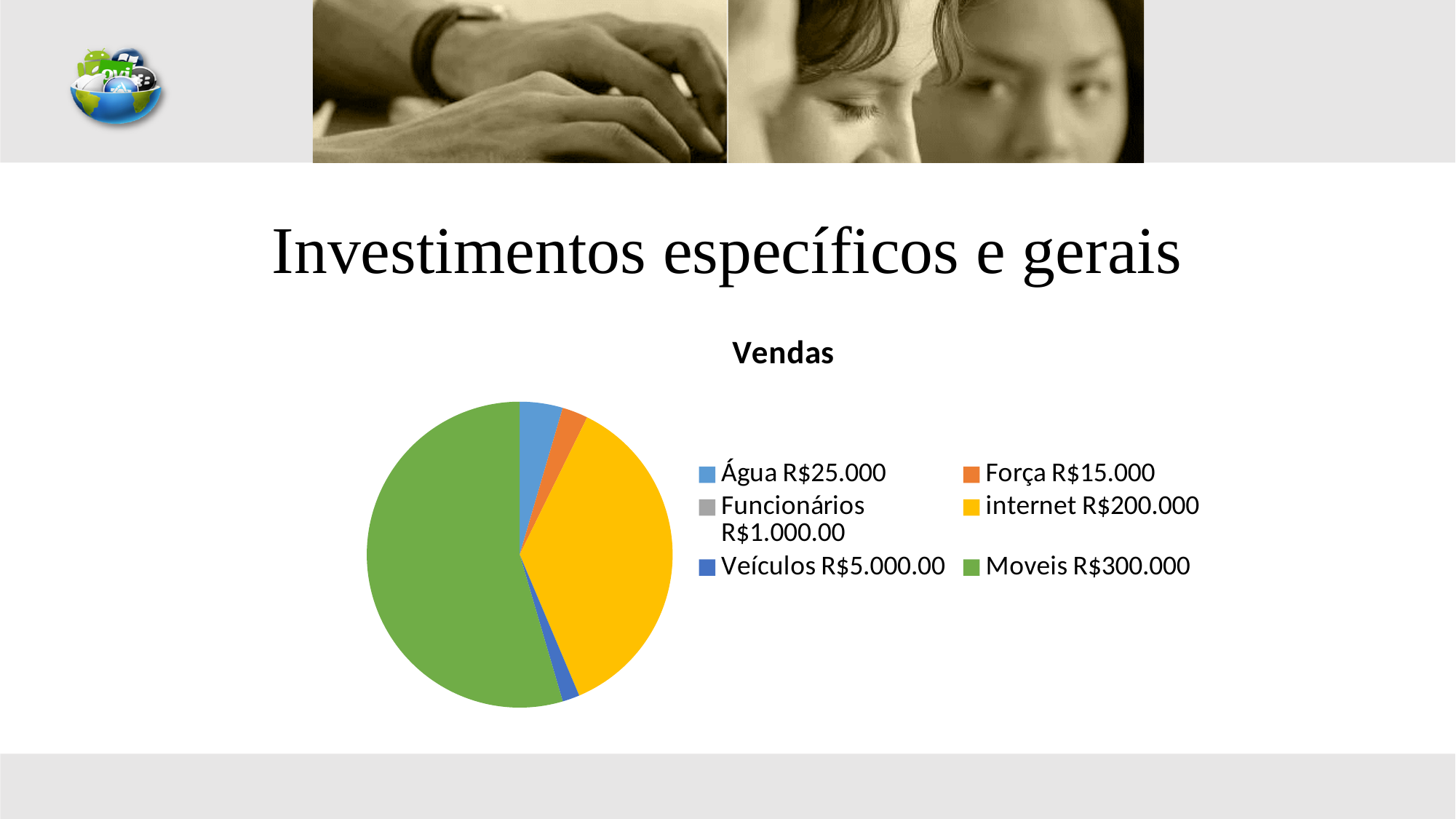
What type of chart is shown on the slide? Pie chart What colour is the Moveis slice? Green What value is shown in the legend for Moveis? R$300.000 What value is shown in the legend for Força? R$15.000 Which slice is larger, Moveis or internet? Moveis What value is shown in the legend for Água? R$25.000 What value is shown in the legend for internet? R$200.000 What is the title of the chart? Vendas Which category has the largest slice of the pie? Moveis How many categories does the pie chart have? 6 Which slice is larger, Água or Força? Água What is the difference between the values for Moveis and internet? R$100.000